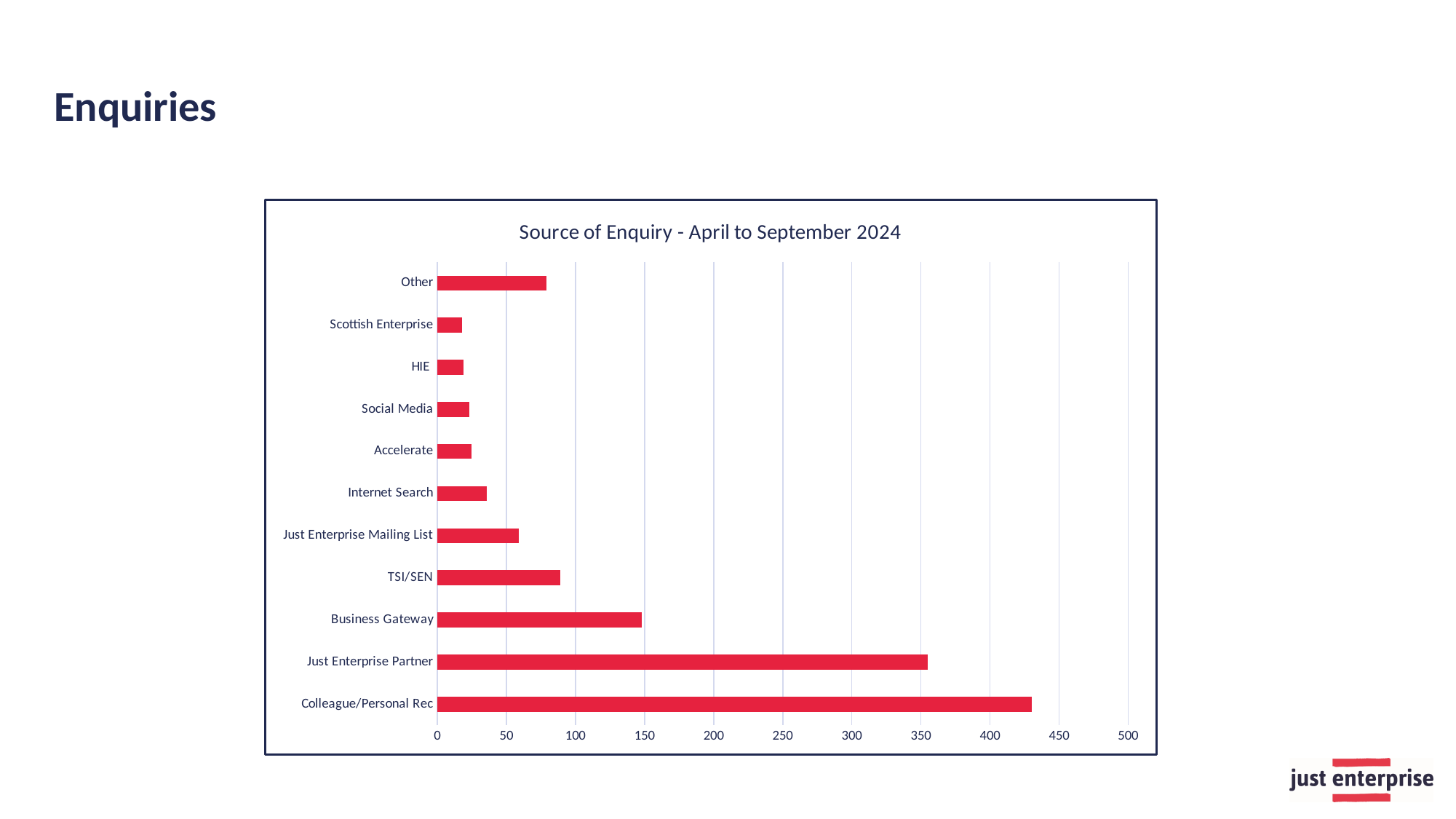
Which has a larger value, Business Gateway or TSI/SEN? Business Gateway What type of chart is shown on the slide? bar chart Is the value for Business Gateway greater or less than 100? greater What is the title of the chart? Source of Enquiry - April to September 2024 Is the value for Internet Search greater or less than 50? less Is the value for Colleague/Personal Rec greater or less than 400? greater Which enquiry source has the highest value? Colleague/Personal Rec What is the highest value shown on the horizontal axis? 500 Which has a larger value, Other or Internet Search? Other How many enquiry source categories are shown in the chart? 11